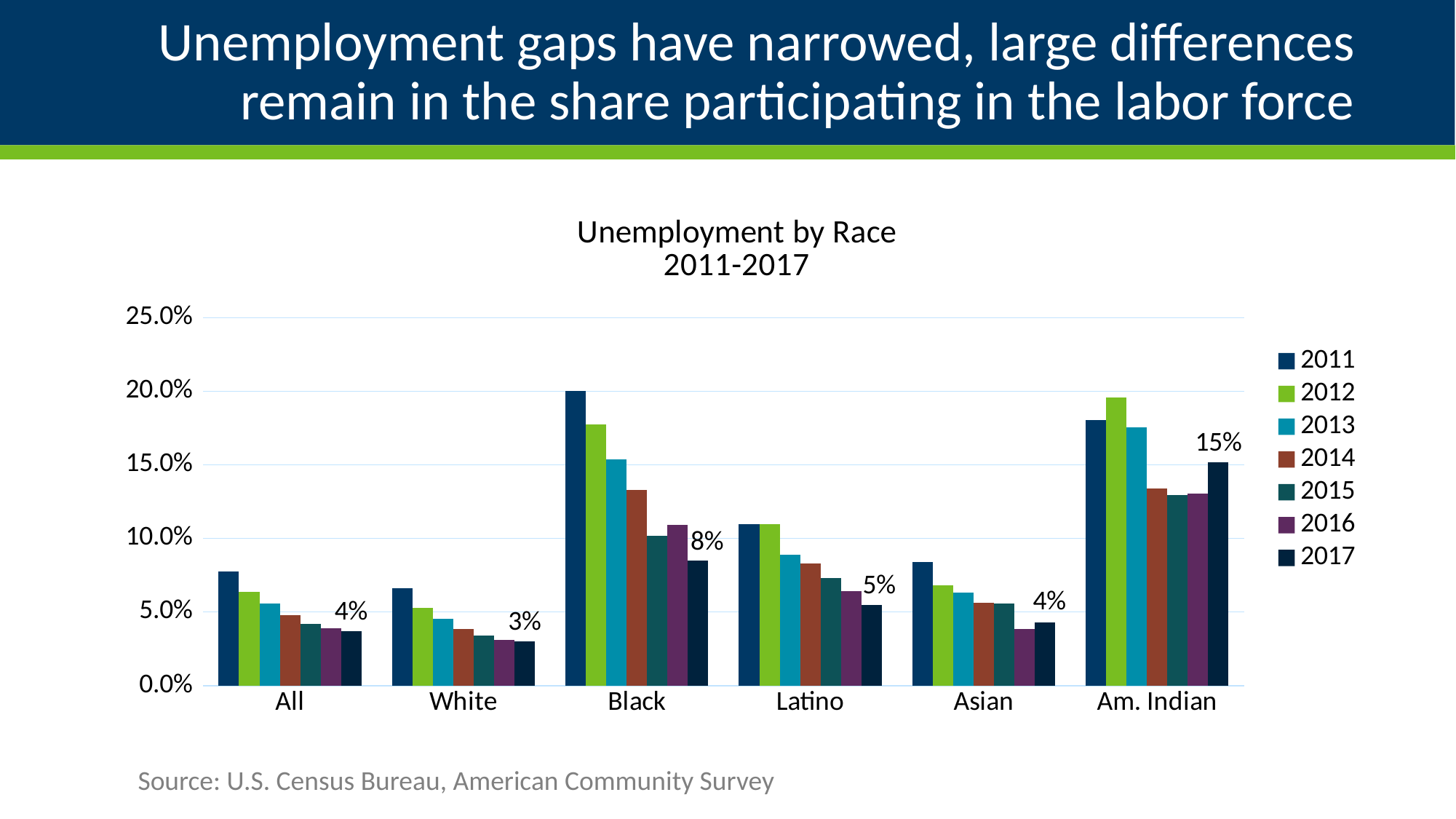
What is the 2017 unemployment rate shown for Am. Indian? 15% How many race categories are shown on the x axis? 6 Which race category has the lowest 2017 unemployment rate? White What is the 2017 unemployment rate shown for White? 3% What kind of chart is shown on the slide? Bar chart How many years does the legend list? 7 What is the 2017 unemployment rate shown for Black? 8% Which race category has the highest 2017 unemployment rate? Am. Indian Which is larger, the 2017 unemployment rate for Black or for Latino? Black What is the difference between the 2017 unemployment rates for Am. Indian and Black? 7% Is the 2011 unemployment rate for Black greater or less than 15.0%? greater What is the 2017 unemployment rate shown for Latino? 5%